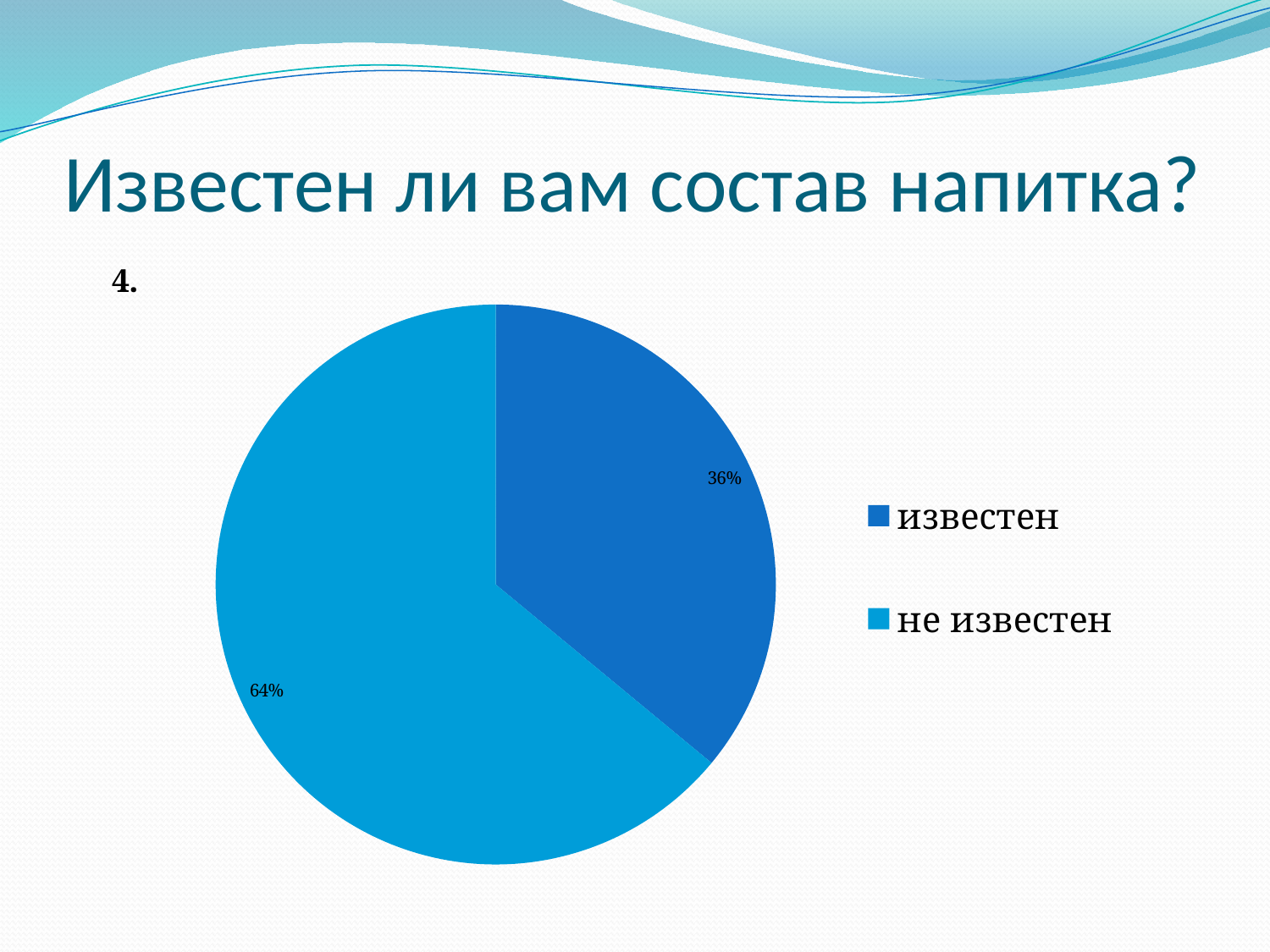
Which category has the largest slice of the pie? не известен Which category has the smallest slice of the pie? известен What kind of chart is shown on the slide? pie chart Which legend entry is shown in the darker blue colour? известен Which is larger, the slice for "известен" or the slice for "не известен"? не известен What is the difference in percentage points between "не известен" and "известен"? 28 What share of the pie does "не известен" have? 64% How many entries does the legend list? 2 What share of the pie does "известен" have? 36% How many slices does the pie chart have? 2 What is the title of the slide above the chart? Известен ли вам состав напитка?